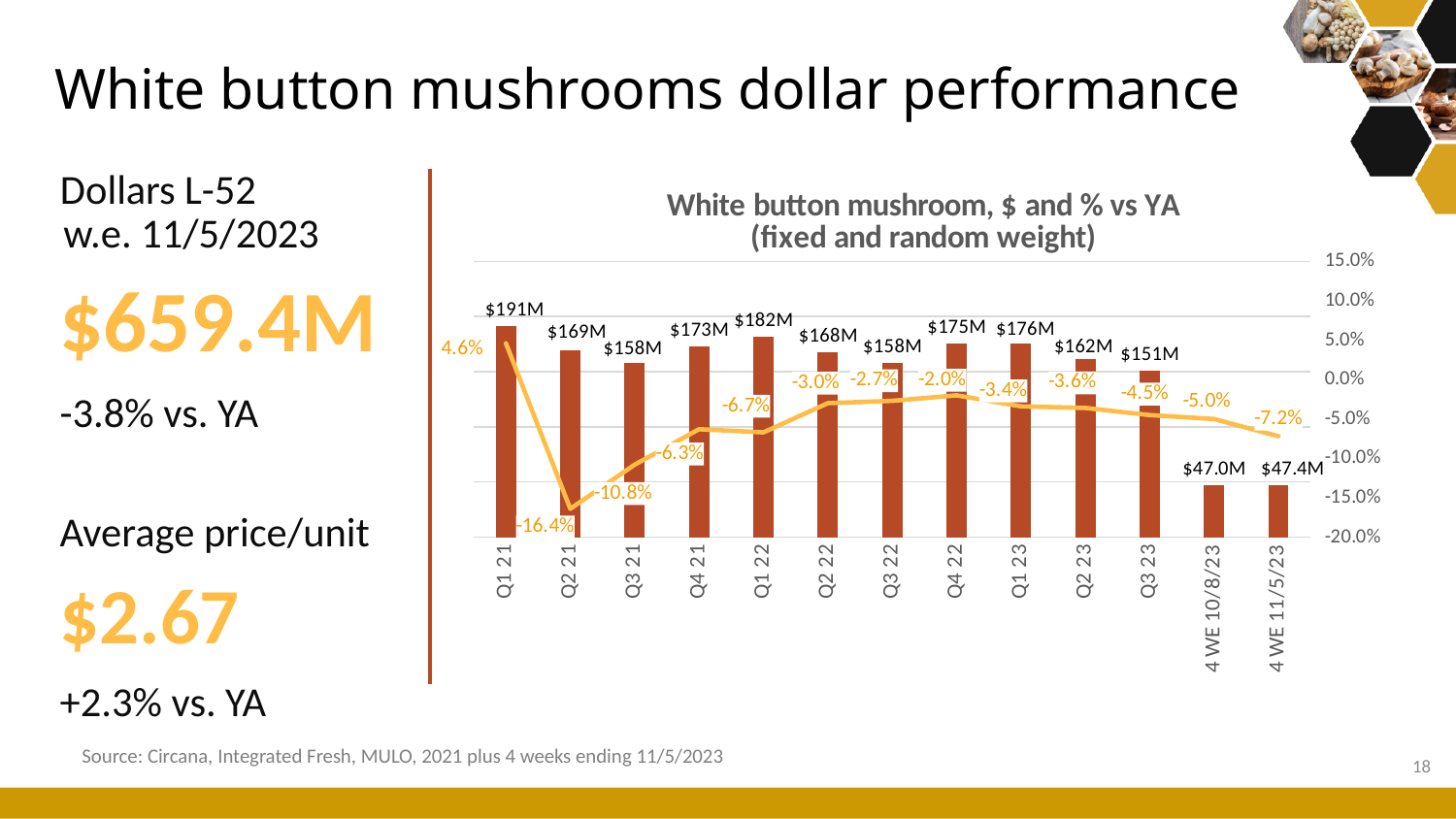
Which quarter has the highest dollar value among the bars? Q1 21 What is the dollar value shown for Q1 21? $191M Which period has the lowest % vs YA value on the line? Q2 21 Which is larger, the dollar value for Q4 22 or for Q3 23? Q4 22 What is the % vs YA value shown for Q2 21? -16.4% What is the % vs YA value shown for Q4 22? -2.0% Do the dollar values of the bars rise or fall from Q1 23 to Q3 23? Fall What is the title of the chart? White button mushroom, $ and % vs YA (fixed and random weight) What is the dollar value shown for the 4 WE 11/5/23 period? $47.4M How many periods are shown on the x axis of the chart? 13 What is the difference in dollar value between Q1 22 and Q2 22? $14M What kind of chart is shown on the slide? Combination bar and line chart